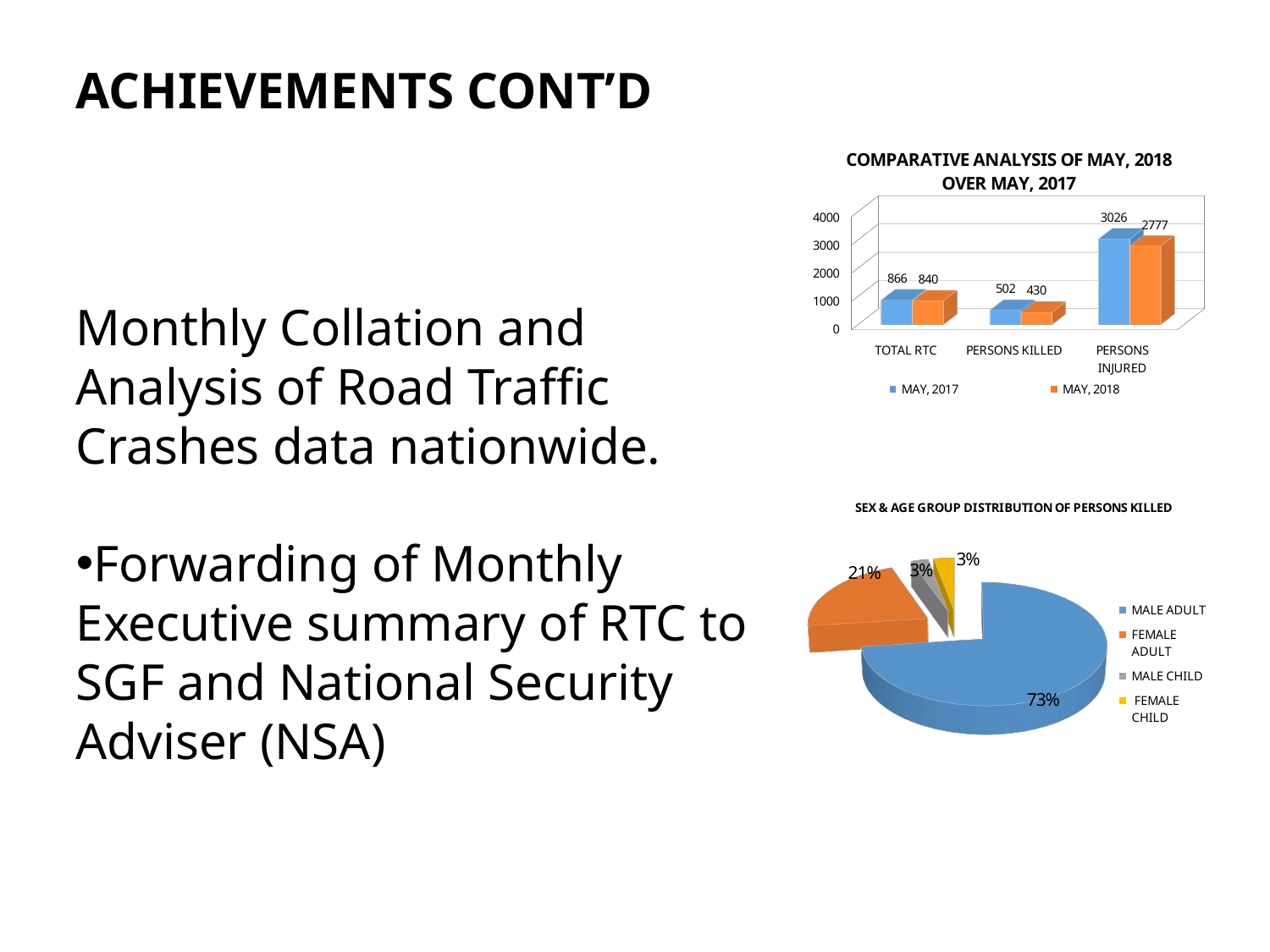
How many series does the legend of the 'Comparative Analysis of May, 2018 over May, 2017' chart list? 2 What kind of chart is the 'Comparative Analysis of May, 2018 over May, 2017' chart? Bar chart In the 'Sex & Age Group Distribution of Persons Killed' chart, what share is Male Adult? 73% In the 'Comparative Analysis of May, 2018 over May, 2017' chart, what is the value for Persons Killed in May, 2018? 430 In the 'Comparative Analysis of May, 2018 over May, 2017' chart, which category has the highest values? Persons Injured In the 'Sex & Age Group Distribution of Persons Killed' chart, what share is Female Adult? 21% In the 'Comparative Analysis of May, 2018 over May, 2017' chart, which is larger: Persons Killed in May, 2017 or in May, 2018? May, 2017 In the 'Comparative Analysis of May, 2018 over May, 2017' chart, what is the difference between Persons Injured in May, 2017 and May, 2018? 249 How many categories does the 'Sex & Age Group Distribution of Persons Killed' pie chart show? 4 In the 'Comparative Analysis of May, 2018 over May, 2017' chart, what is the value for Total RTC in May, 2017? 866 In the 'Comparative Analysis of May, 2018 over May, 2017' chart, what is the value for Persons Injured in May, 2017? 3026 In the 'Comparative Analysis of May, 2018 over May, 2017' chart, which category has the lowest values? Persons Killed